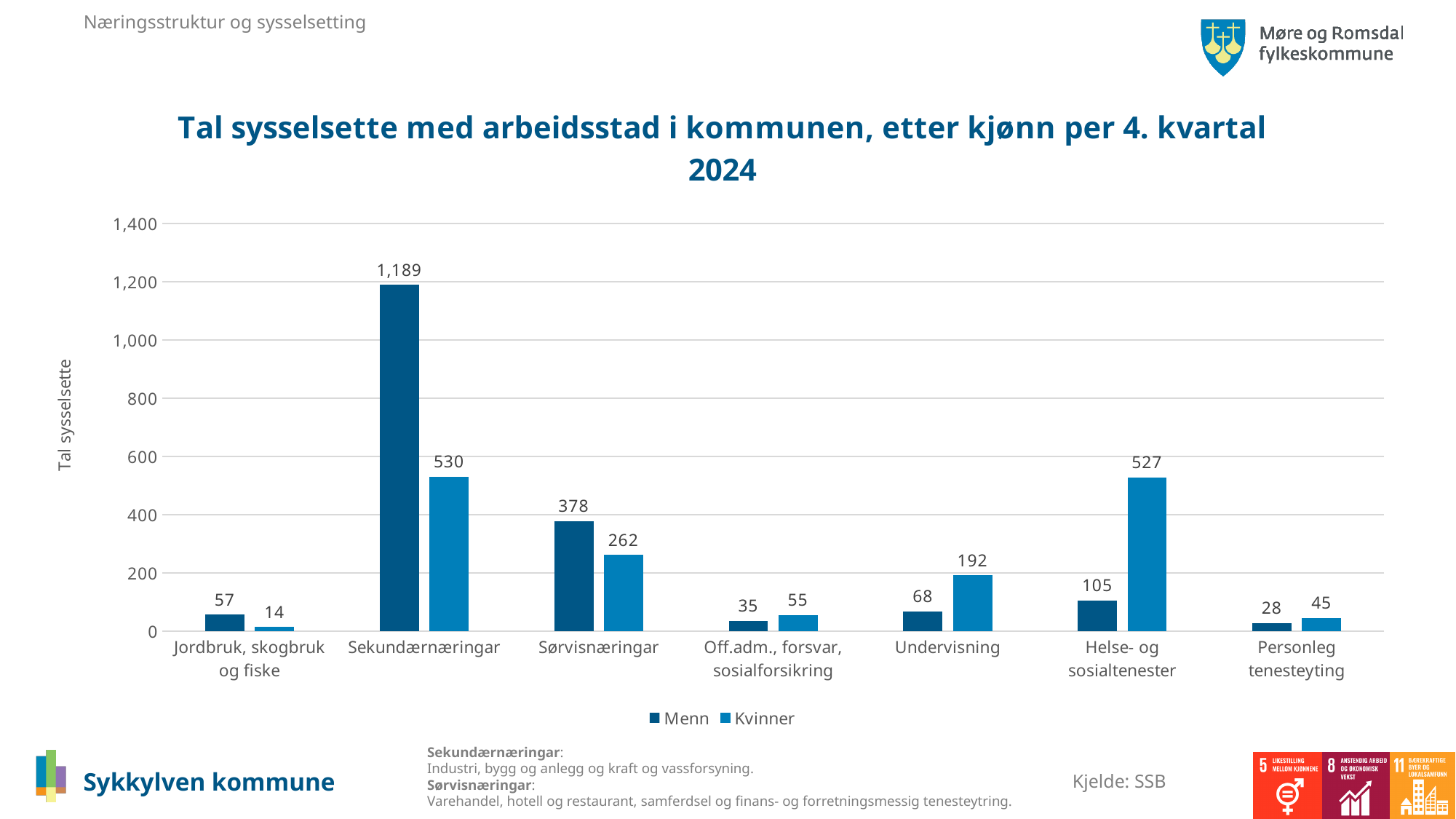
What kind of chart is shown on the slide? bar chart What is the difference between Menn and Kvinner in Sørvisnæringar? 116 Is the value for Kvinner in Sekundærnæringar greater or less than 600? less Which category has the highest value for Menn? Sekundærnæringar How many series does the legend list? 2 What is the label of the y axis? Tal sysselsette Which category has the lowest value for Kvinner? Jordbruk, skogbruk og fiske What is the value for Kvinner in Helse- og sosialtenester? 527 Which is larger in Undervisning, Menn or Kvinner? Kvinner How many categories are shown on the x axis? 7 What is the value for Menn in Sekundærnæringar? 1,189 What is the value for Kvinner in Jordbruk, skogbruk og fiske? 14